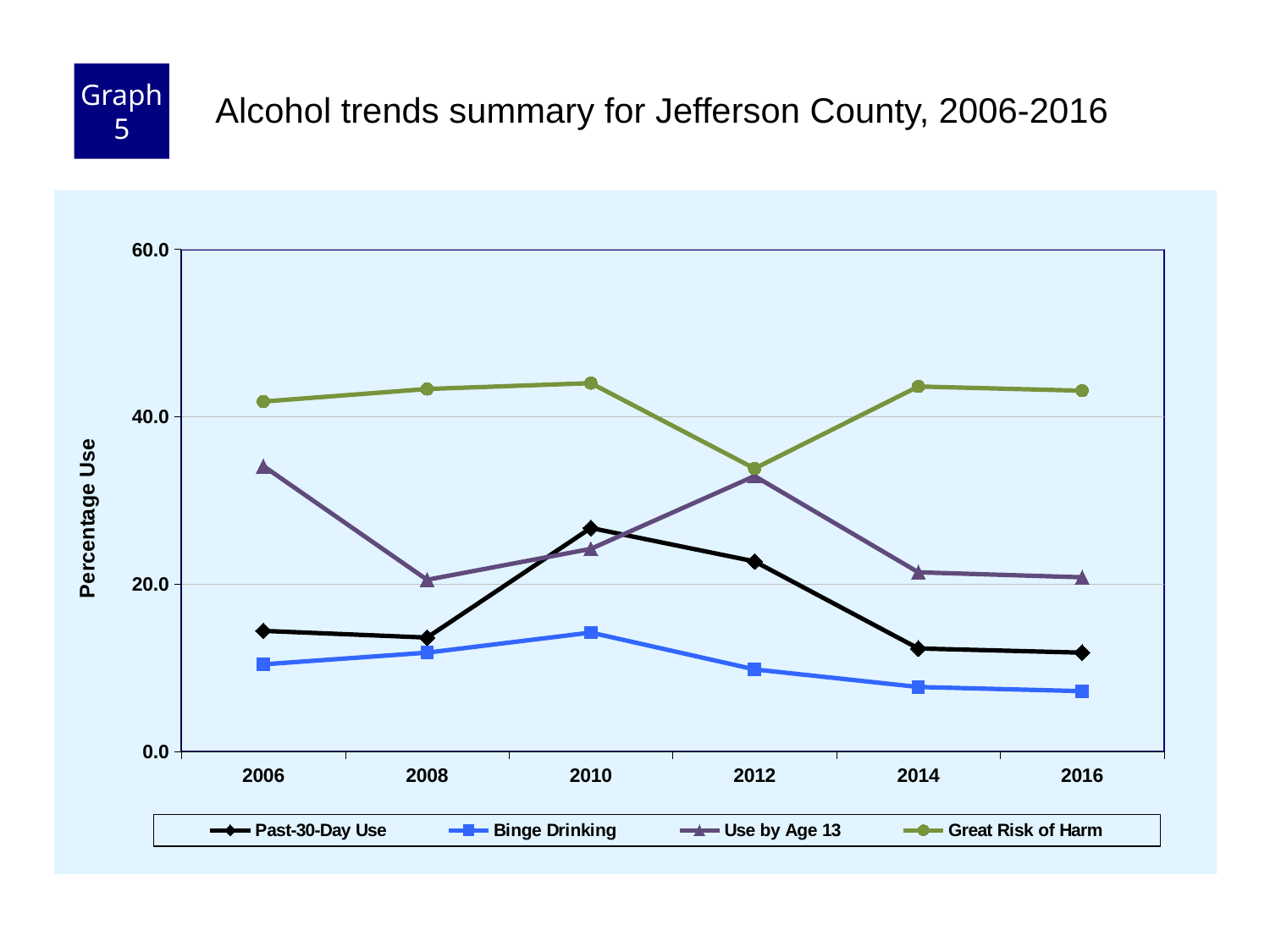
What is the label on the y axis? Percentage Use In which year is Past-30-Day Use at its highest? 2010 Is the value for Use by Age 13 in 2012 greater or less than 40.0? less What is the title of the chart? Alcohol trends summary for Jefferson County, 2006-2016 Is the value for Great Risk of Harm in 2006 greater or less than 40.0? greater In which year is Great Risk of Harm at its lowest? 2012 How many years are plotted along the x axis? 6 Is the value for Past-30-Day Use in 2010 greater or less than 20.0? greater In 2006, which is larger: Use by Age 13 or Past-30-Day Use? Use by Age 13 Does Binge Drinking rise or fall from 2010 to 2016? fall What kind of chart is shown on the slide? line chart How many series does the legend list? 4